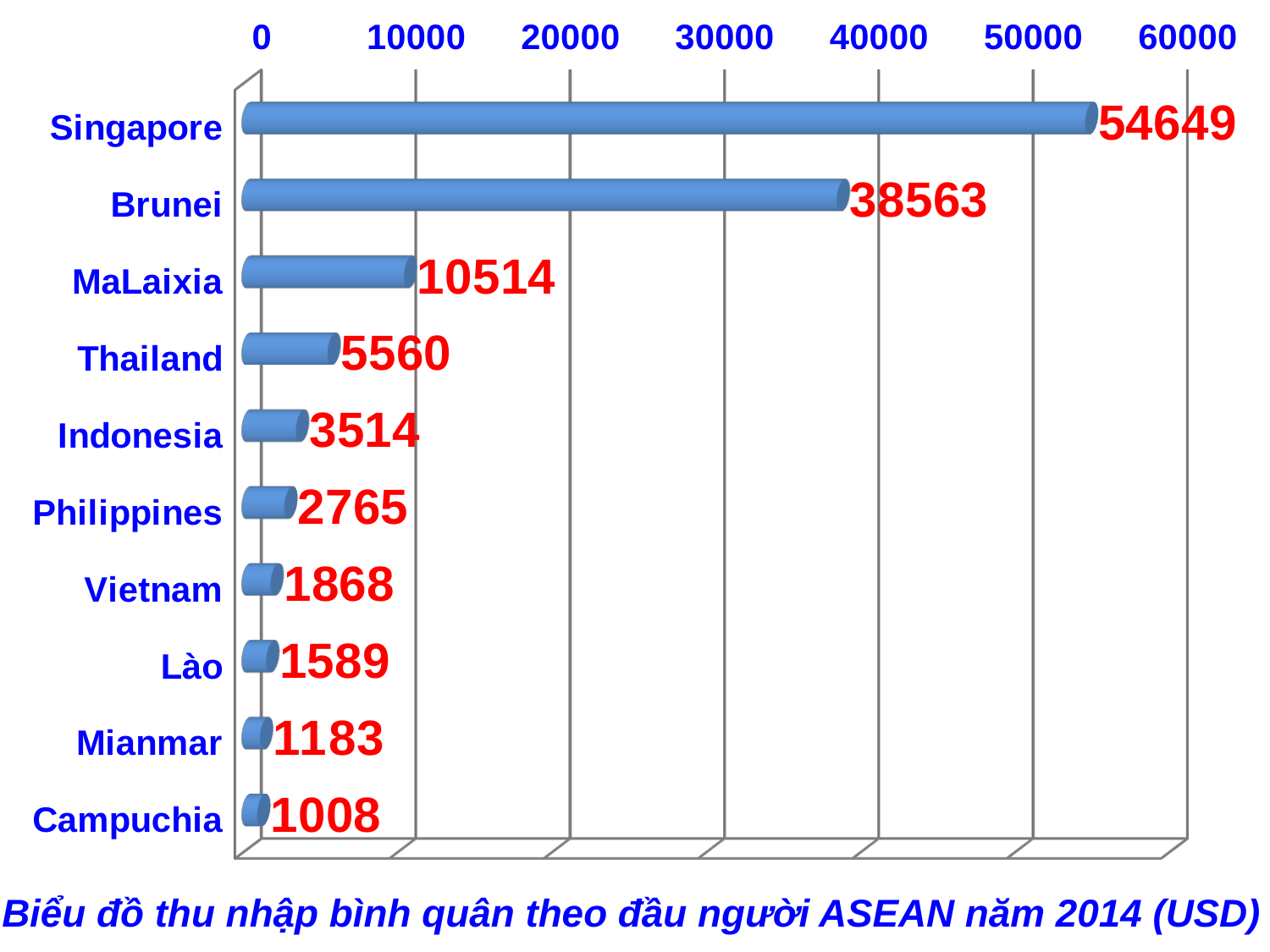
Which country has the lowest value? Campuchia What is the value for Singapore? 54649 What is the value for Thailand? 5560 What is the title of the chart? Biểu đồ thu nhập bình quân theo đầu người ASEAN năm 2014 (USD) Which country has the highest value? Singapore What is the difference between the values for Vietnam and Lào? 279 What kind of chart is shown on the slide? bar chart What is the difference between the values for Singapore and Brunei? 16086 Which is larger, the value for Indonesia or the value for Philippines? Indonesia Is the value for MaLaixia greater or less than 10000? greater How many countries are shown in the chart? 10 What is the value for Vietnam? 1868